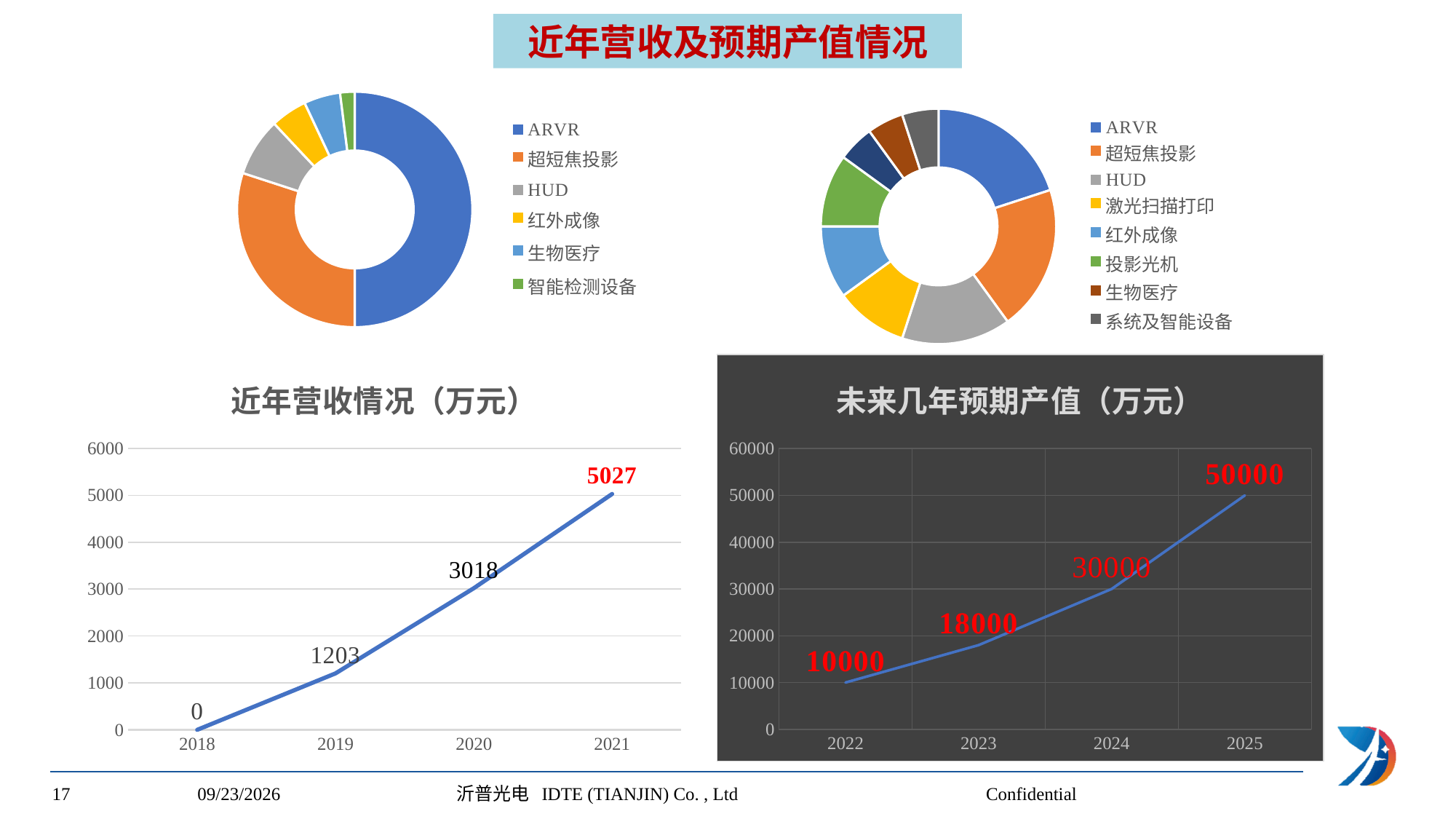
In the chart titled 近年营收情况（万元）, what is the value for 2021? 5027 How many entries does the legend of the donut chart at the top right of the slide list? 8 In the chart titled 近年营收情况（万元）, what is the difference between the 2021 and 2020 values? 2009 In the chart titled 近年营收情况（万元）, what is the value for 2019? 1203 In the chart titled 未来几年预期产值（万元）, which year has the highest value? 2025 In the chart titled 未来几年预期产值（万元）, what is the difference between the 2025 and 2024 values? 20000 In the chart titled 未来几年预期产值（万元）, which is larger, the value for 2022 or the value for 2023? 2023 In the donut chart at the top left of the slide, which category has the largest slice? ARVR In the chart titled 未来几年预期产值（万元）, what is the value for 2023? 18000 In the chart titled 近年营收情况（万元）, do the values rise or fall from 2018 to 2021? rise What kind of chart is the one titled 近年营收情况（万元）? line chart In the chart titled 未来几年预期产值（万元）, how many years are plotted? 4